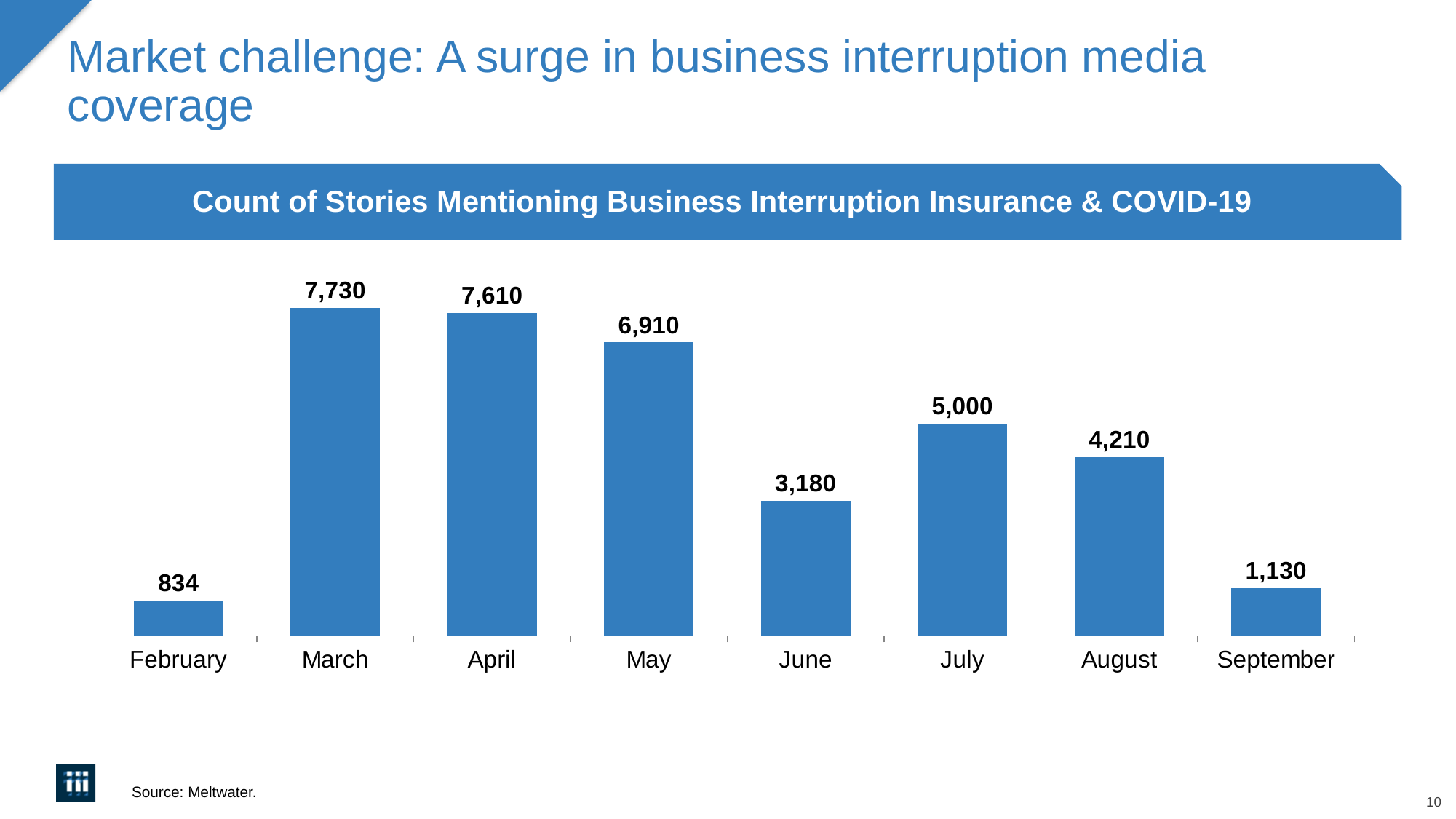
What is the difference between the counts for July and August? 790 What is the difference between the counts for March and April? 120 Which month has a higher count of stories, May or July? May What kind of chart is shown on the slide? Bar chart Do the counts rise or fall from May to June? Fall Which month has the lowest count of stories? February What is the count of stories for March? 7,730 What is the title of the chart? Count of Stories Mentioning Business Interruption Insurance & COVID-19 What is the count of stories for June? 3,180 Which month has the highest count of stories? March How many months are shown on the chart? 8 What is the count of stories for September? 1,130